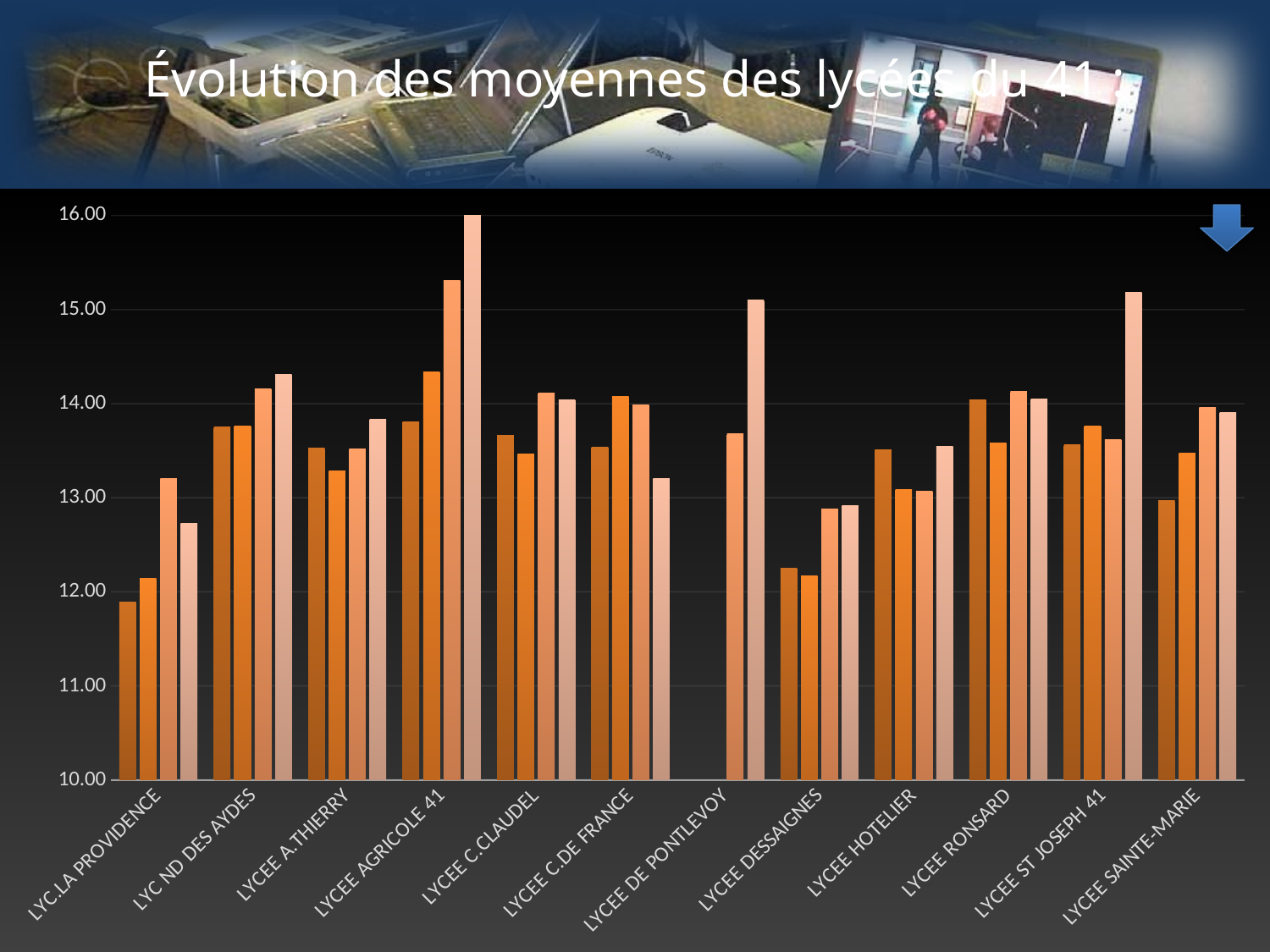
What is the title of the chart slide? Évolution des moyennes des lycées du 41 What kind of chart is shown on the slide? bar chart How many bars are shown for LYCEE DE PONTLEVOY? 2 How many lycées (categories) are shown on the x axis of the chart? 12 Is the value of the first bar for LYCEE DESSAIGNES greater or less than 13.00? less Which lycée has the tallest bar in the chart? LYCEE AGRICOLE 41 Is the value of the first bar for LYCEE HOTELIER greater or less than 13.00? greater What is the highest value shown on the vertical axis of the chart? 16.00 Which lycée has the shortest bar in the chart? LYC.LA PROVIDENCE Is the value of the first bar for LYC.LA PROVIDENCE greater or less than 12.00? less Which is larger: the tallest bar for LYCEE AGRICOLE 41 or the bar for LYCEE DE PONTLEVOY? LYCEE AGRICOLE 41